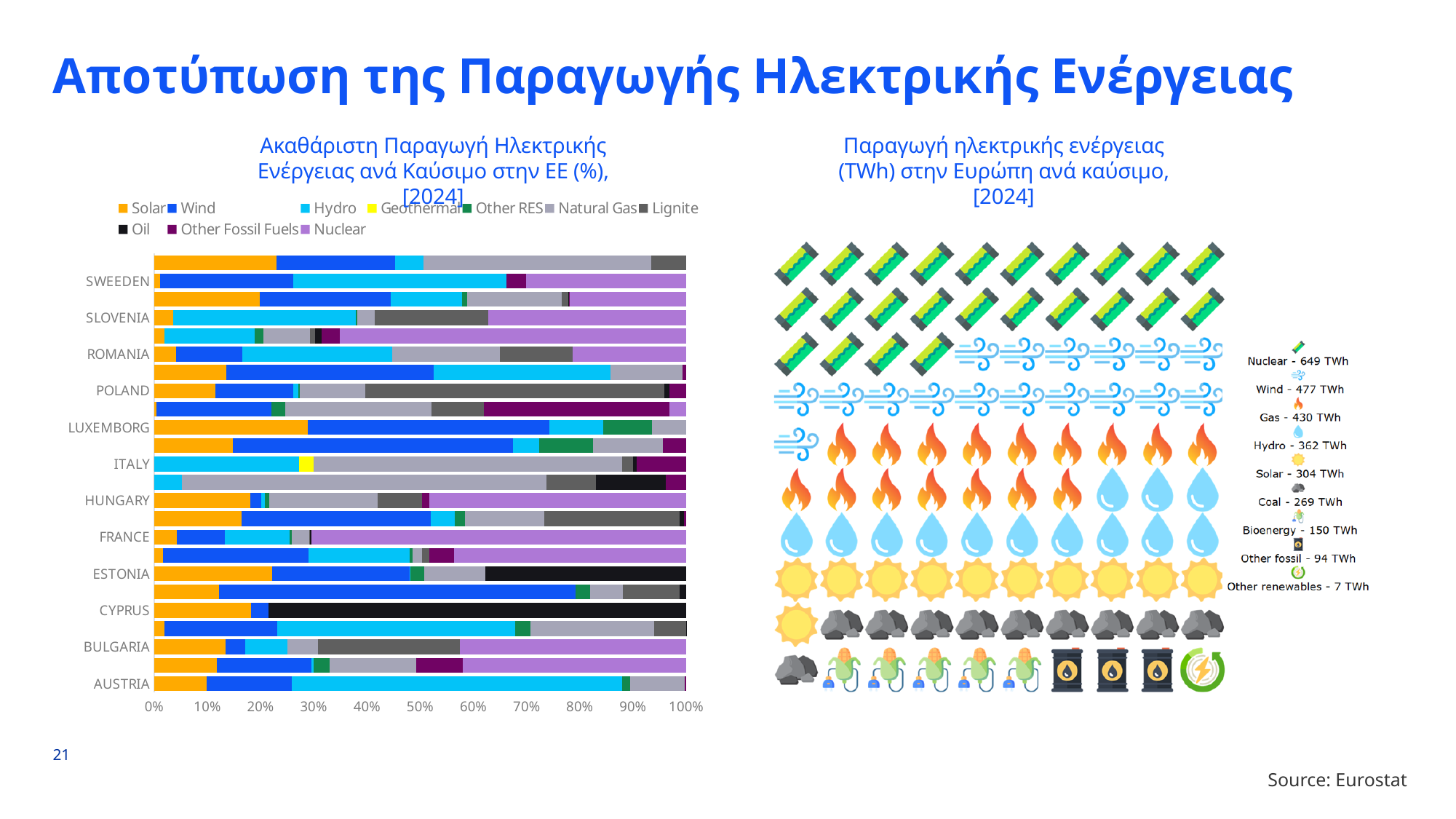
In the left-hand chart (EU generation by fuel, %), is the Oil share for Cyprus greater or less than 70%? greater In the right-hand chart (TWh by fuel, 2024), what is the difference between Nuclear and Wind generation? 172 TWh In the right-hand chart (TWh by fuel, 2024), which fuel has the lowest generation? Other renewables In the right-hand chart (TWh by fuel, 2024), which fuel has the highest generation? Nuclear In the right-hand chart (TWh by fuel, 2024), what is the value for Hydro? 362 TWh In the right-hand chart (TWh by fuel, 2024), which is larger, Gas or Hydro? Gas What kind of chart is the left-hand chart (Ακαθάριστη Παραγωγή Ηλεκτρικής Ενέργειας ανά Καύσιμο στην ΕΕ (%), 2024)? Stacked bar chart How many series does the legend of the left-hand chart (EU generation by fuel, %) list? 10 In the right-hand chart (Παραγωγή ηλεκτρικής ενέργειας (TWh) στην Ευρώπη ανά καύσιμο, 2024), what is the value for Nuclear? 649 TWh In the right-hand chart (TWh by fuel, 2024), what is the value for Coal? 269 TWh In the left-hand chart (EU generation by fuel, %), which colour represents Nuclear in the legend? Purple In the right-hand chart (TWh by fuel, 2024), how many fuel types are listed? 9